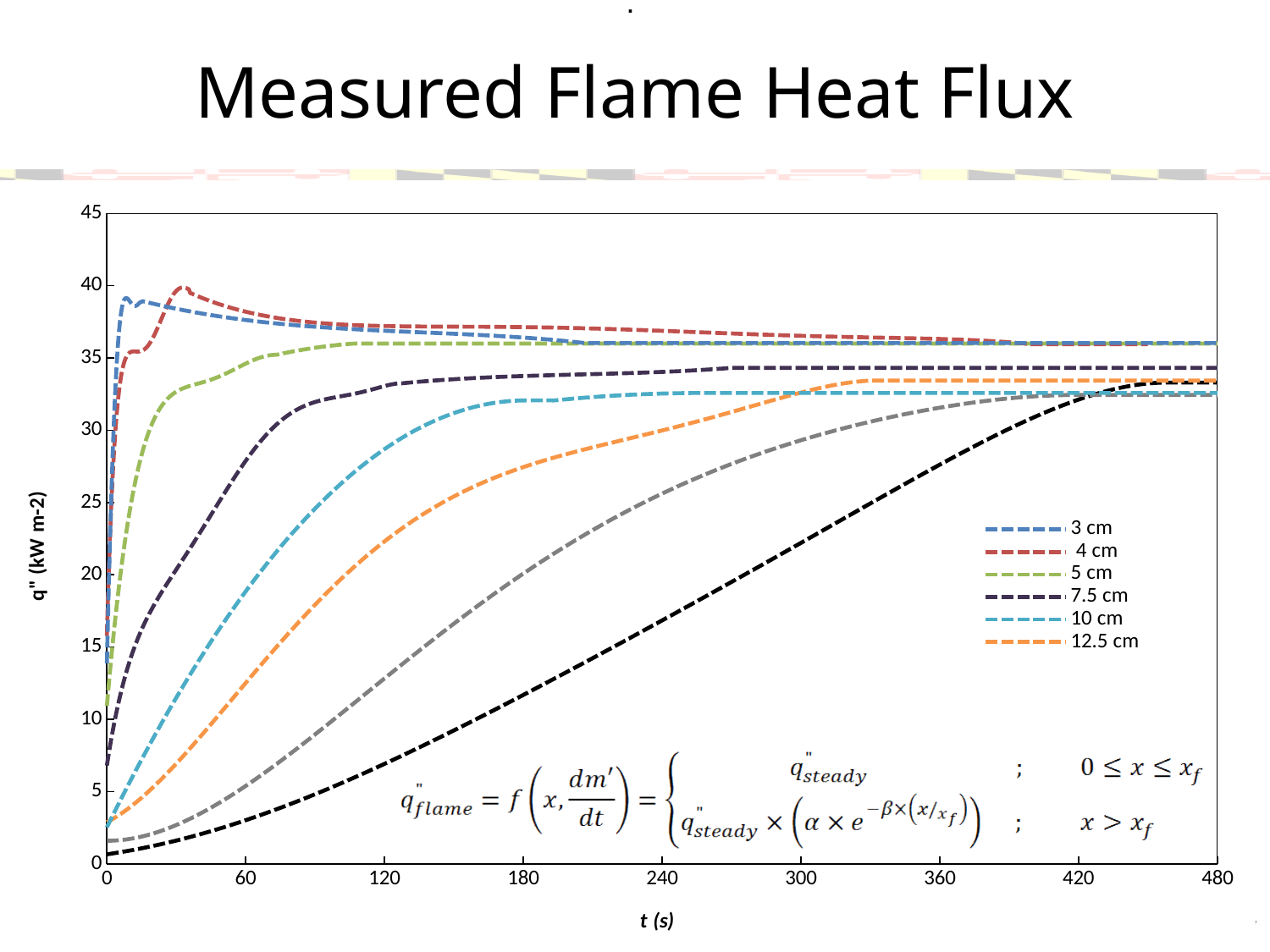
Is the value for 10 cm at t = 120 s greater or less than 25? greater Is the value for 12.5 cm at t = 120 s greater or less than 25? less Among the legend series, which has the lowest value at t = 60 s? 12.5 cm Is the value for 3 cm at t = 60 s greater or less than 35? greater What is the title of the chart? Measured Flame Heat Flux Does the 12.5 cm series rise or fall as t increases from 0 to 300 s? rise What kind of chart is shown on the slide? line chart What is the label of the x axis? t (s) At t = 120 s, which is larger: the value for 3 cm or the value for 12.5 cm? 3 cm How many series does the legend list? 6